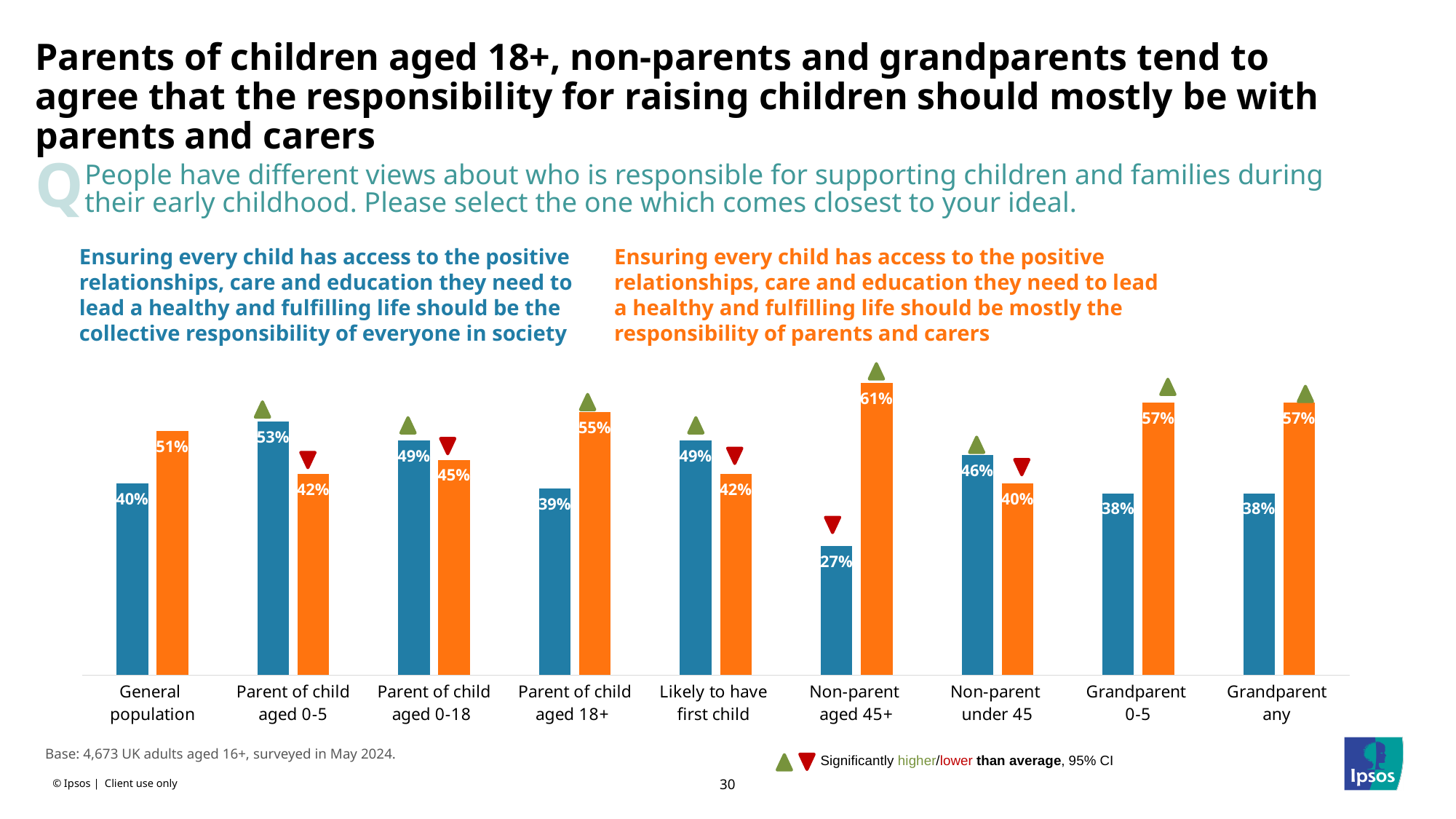
Which group has the lowest value for the 'collective responsibility of everyone in society' option? Non-parent aged 45+ What percentage of non-parents aged 45+ chose the 'mostly the responsibility of parents and carers' option? 61% Which group has the highest value for the 'mostly the responsibility of parents and carers' option? Non-parent aged 45+ What is the difference between the 'parents and carers' value and the 'collective responsibility' value for parents of children aged 18+? 16 percentage points How many series does the chart show? 2 How many groups are shown along the x axis of the chart? 9 What kind of chart is shown on the slide? Bar chart What is the 'mostly the responsibility of parents and carers' value for grandparents of children aged 0-5? 57% What percentage of the general population chose the 'collective responsibility of everyone in society' option? 40% What percentage of parents of children aged 0-5 chose the 'collective responsibility of everyone in society' option? 53% For non-parents under 45, which option has the larger value: 'collective responsibility of everyone in society' or 'mostly the responsibility of parents and carers'? Collective responsibility of everyone in society Which colour represents the 'mostly the responsibility of parents and carers' option in the chart? Orange